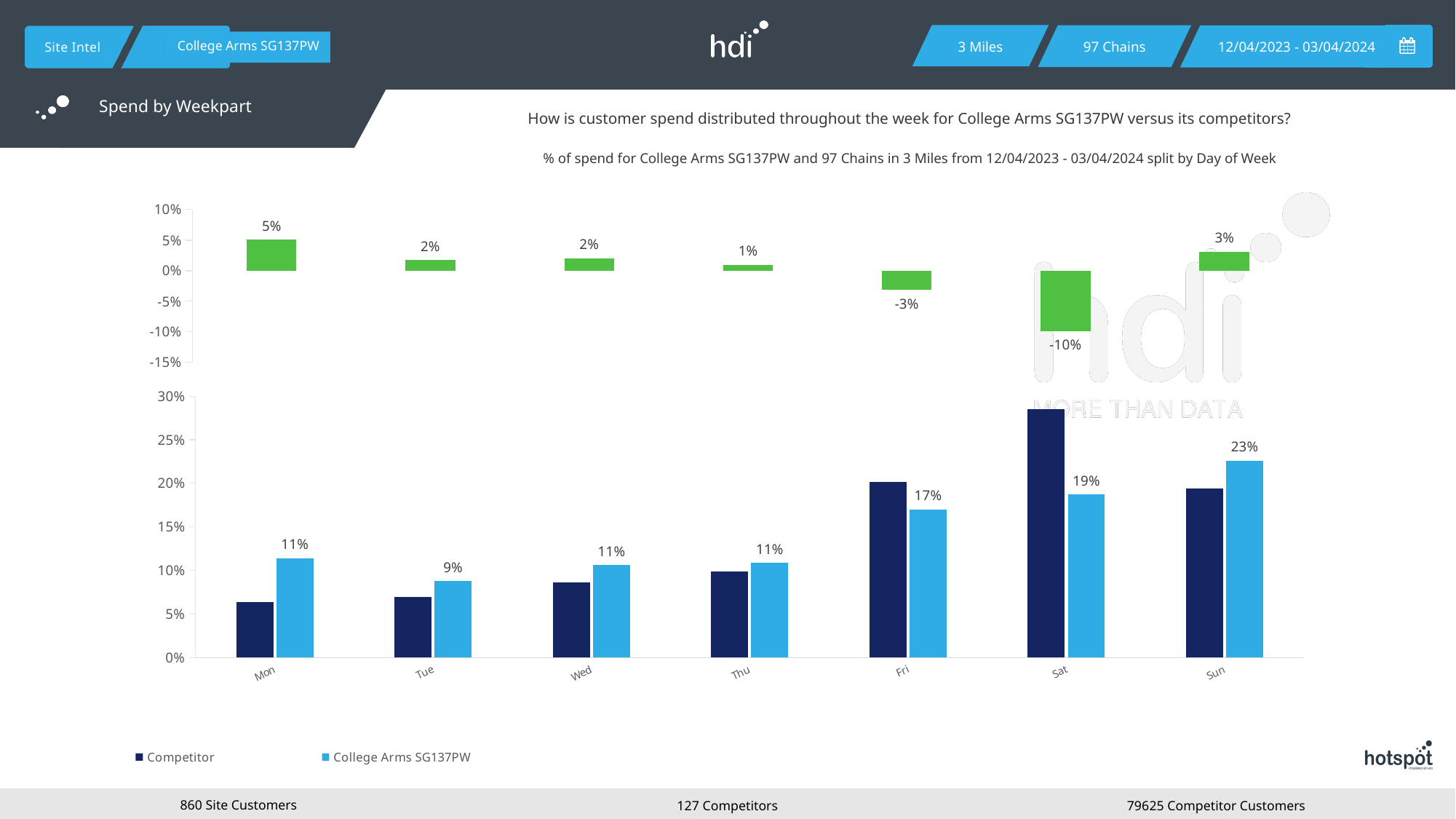
In the top chart, which day has the lowest value? Sat In the bottom chart, which is larger on Sat: the Competitor bar or the College Arms SG137PW bar? Competitor In the bottom chart, on which day is the College Arms SG137PW value highest? Sun In the bottom chart, is the Competitor value for Mon greater or less than 10%? less In the top chart, what is the value shown for Mon? 5% In the bottom chart, what is the value for College Arms SG137PW on Tue? 9% In the bottom chart, what is the difference between the College Arms SG137PW values for Sun and Sat? 4% In the top chart, what is the value shown for Sat? -10% How many series does the legend of the bottom chart list? 2 In the bottom chart, what is the value for College Arms SG137PW on Sun? 23% How many days of the week are shown on the x axis of the bottom chart? 7 In the bottom chart, is the Competitor value for Sat greater or less than 25%? greater